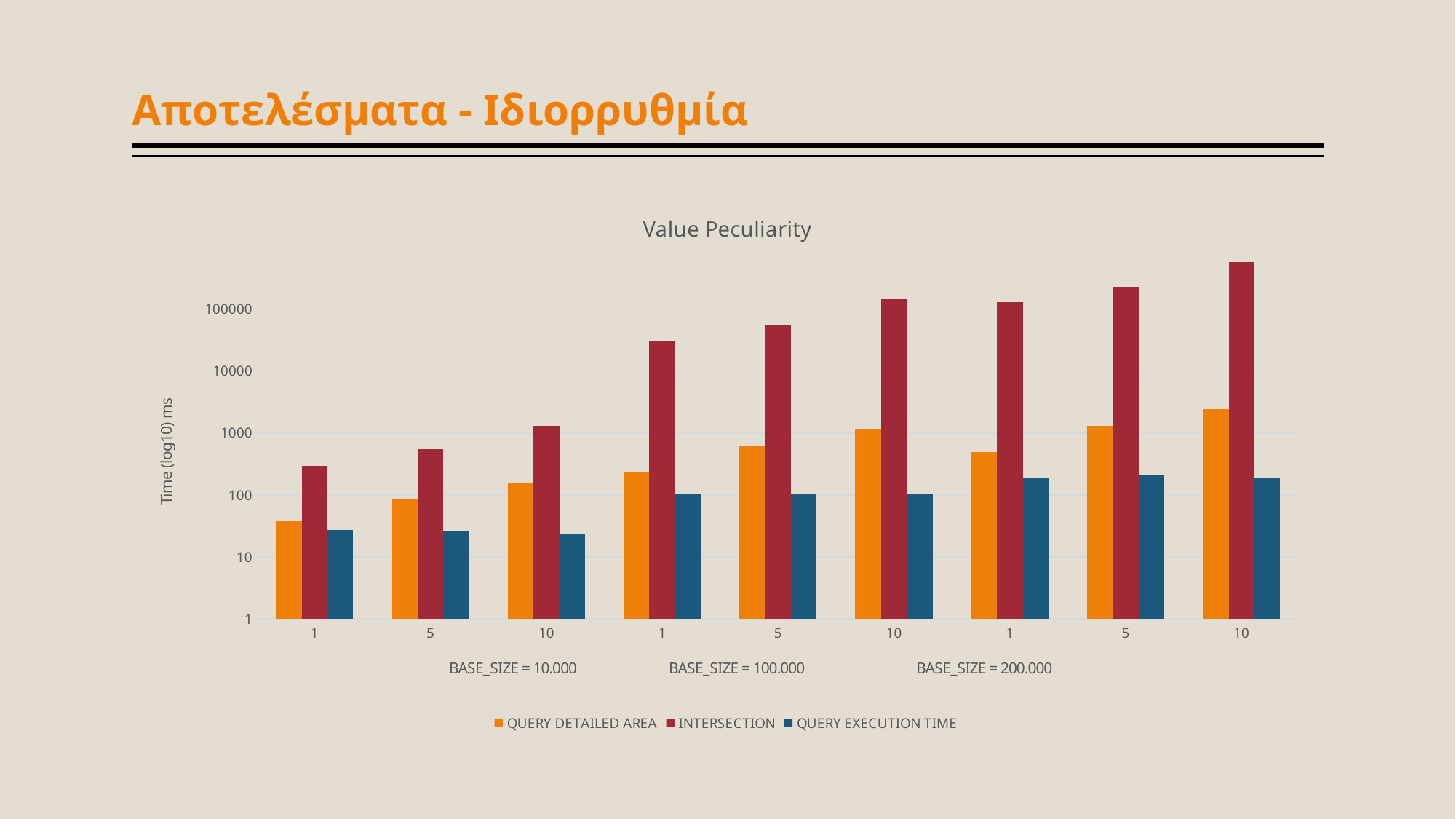
Is the INTERSECTION value for 10 at BASE_SIZE = 200.000 greater or less than 100000? greater What is the title of the chart? Value Peculiarity For which category is the QUERY DETAILED AREA bar lowest? 1 at BASE_SIZE = 10.000 How many series does the legend list? 3 Which series has the tallest bar in every group? INTERSECTION How many groups of bars (x-axis categories) are plotted in the chart? 9 Is the QUERY DETAILED AREA value for 10 at BASE_SIZE = 200.000 greater or less than 1000? greater What kind of chart is shown on the slide? Bar chart What is the label of the vertical axis? Time (log10) ms Is the QUERY EXECUTION TIME value for 1 at BASE_SIZE = 10.000 greater or less than 100? less Within BASE_SIZE = 100.000, do the INTERSECTION values rise or fall from 1 to 10? rise For 5 at BASE_SIZE = 100.000, which is larger: INTERSECTION or QUERY DETAILED AREA? INTERSECTION